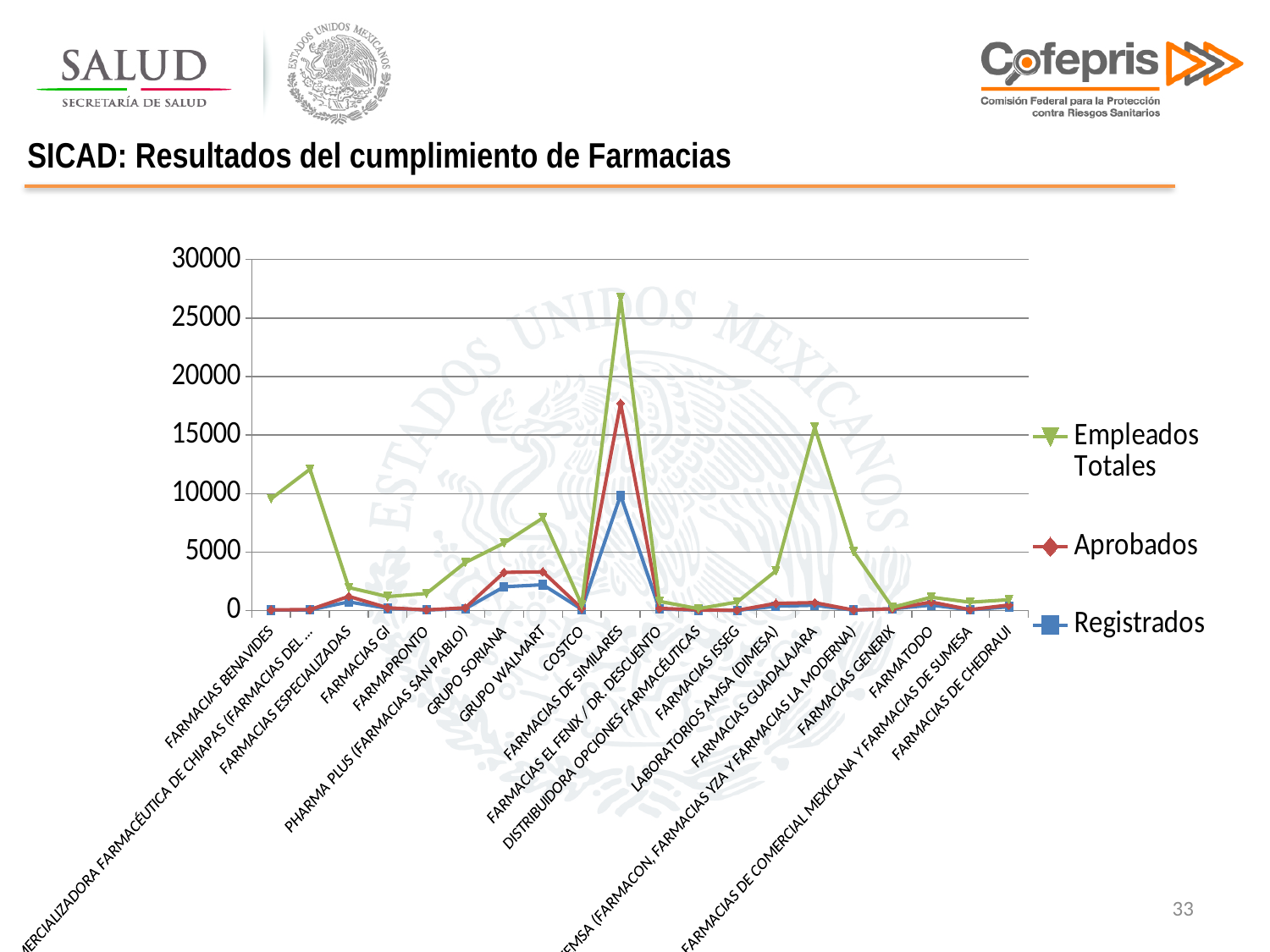
Which has the higher Empleados Totales value, FARMACIAS GUADALAJARA or GRUPO WALMART? FARMACIAS GUADALAJARA Which series are listed in the legend? Empleados Totales, Aprobados, Registrados What kind of chart is shown on the slide? line chart What is the title of the slide containing the chart? SICAD: Resultados del cumplimiento de Farmacias Is the Empleados Totales value for FARMACIAS GUADALAJARA greater or less than 10000? greater Which category has the highest value for Aprobados? FARMACIAS DE SIMILARES Is the Registrados value for FARMACIAS DE SIMILARES greater or less than 15000? less How many series does the legend list? 3 Which has the higher Aprobados value, FARMACIAS DE SIMILARES or GRUPO SORIANA? FARMACIAS DE SIMILARES How many pharmacy categories are plotted along the x axis? 20